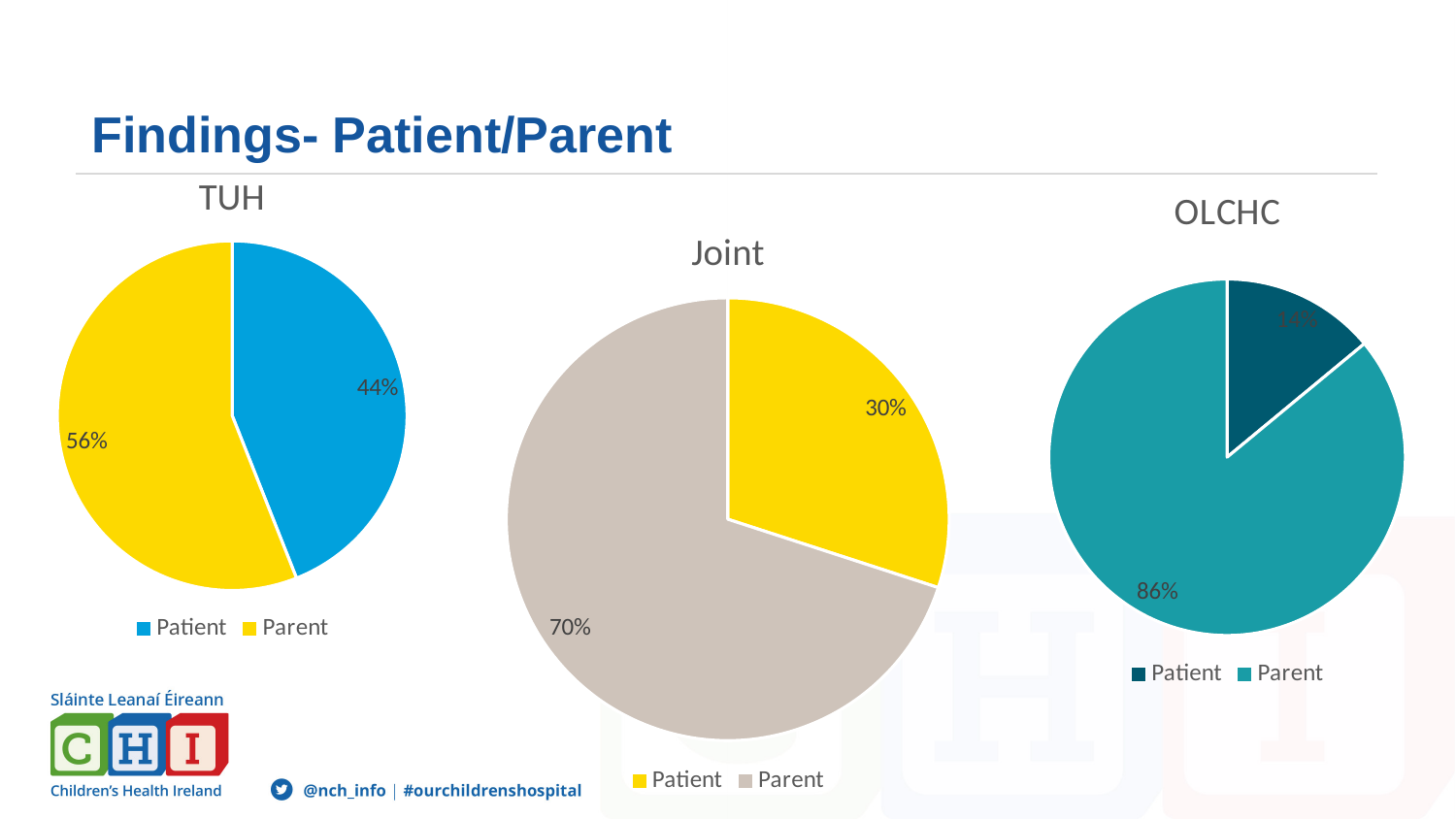
In the TUH chart, what is the difference between the Parent and Patient percentages? 12% In the TUH chart, which category has the largest share? Parent In the TUH chart, what percentage is shown for Parent? 56% In the Joint chart, what percentage is shown for Patient? 30% In the OLCHC chart, what percentage is shown for Parent? 86% What type of chart is the Joint chart? Pie chart In the OLCHC chart, which slice is larger, Patient or Parent? Parent In the Joint chart, which category has the smallest share? Patient How many series does the legend of the OLCHC chart list? 2 In the Joint chart, what percentage is shown for Parent? 70% In the Joint chart, what is the difference between the Parent and Patient percentages? 40% In the TUH chart, what percentage is shown for Patient? 44%